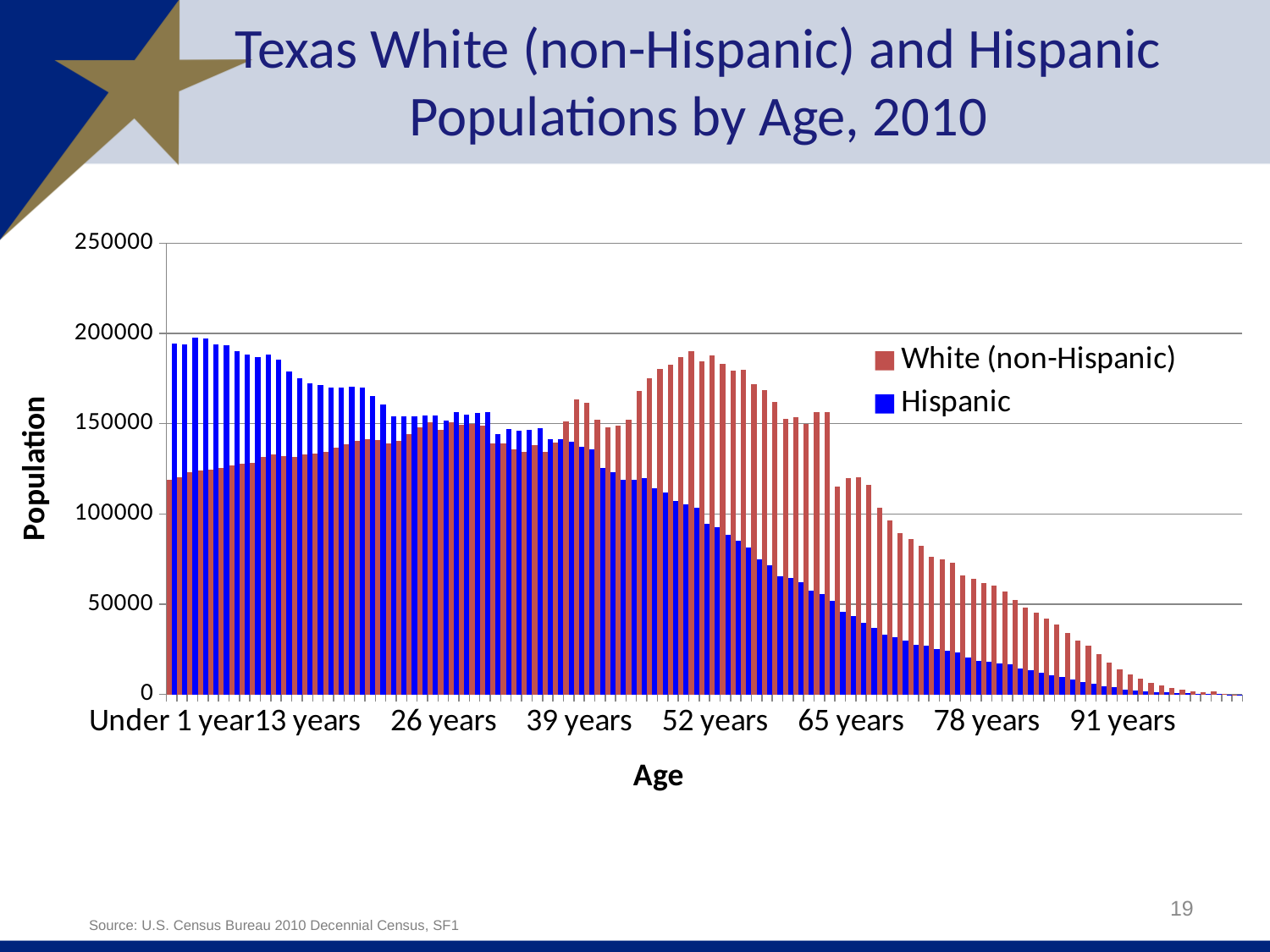
Is the White (non-Hispanic) value for Under 1 year greater or less than 150000? less What kind of chart is shown on the slide? Bar chart At Under 1 year, which series has the larger value, White (non-Hispanic) or Hispanic? Hispanic Which two series are listed in the chart legend? White (non-Hispanic) and Hispanic Is the Hispanic value for Under 1 year greater or less than 150000? greater Is the White (non-Hispanic) value for 78 years greater or less than 50000? greater Do the Hispanic values generally rise or fall from Under 1 year to 91 years along the x axis? fall How many series does the legend list? 2 At 65 years, which series has the larger value, White (non-Hispanic) or Hispanic? White (non-Hispanic) What is the title of the chart on the slide? Texas White (non-Hispanic) and Hispanic Populations by Age, 2010